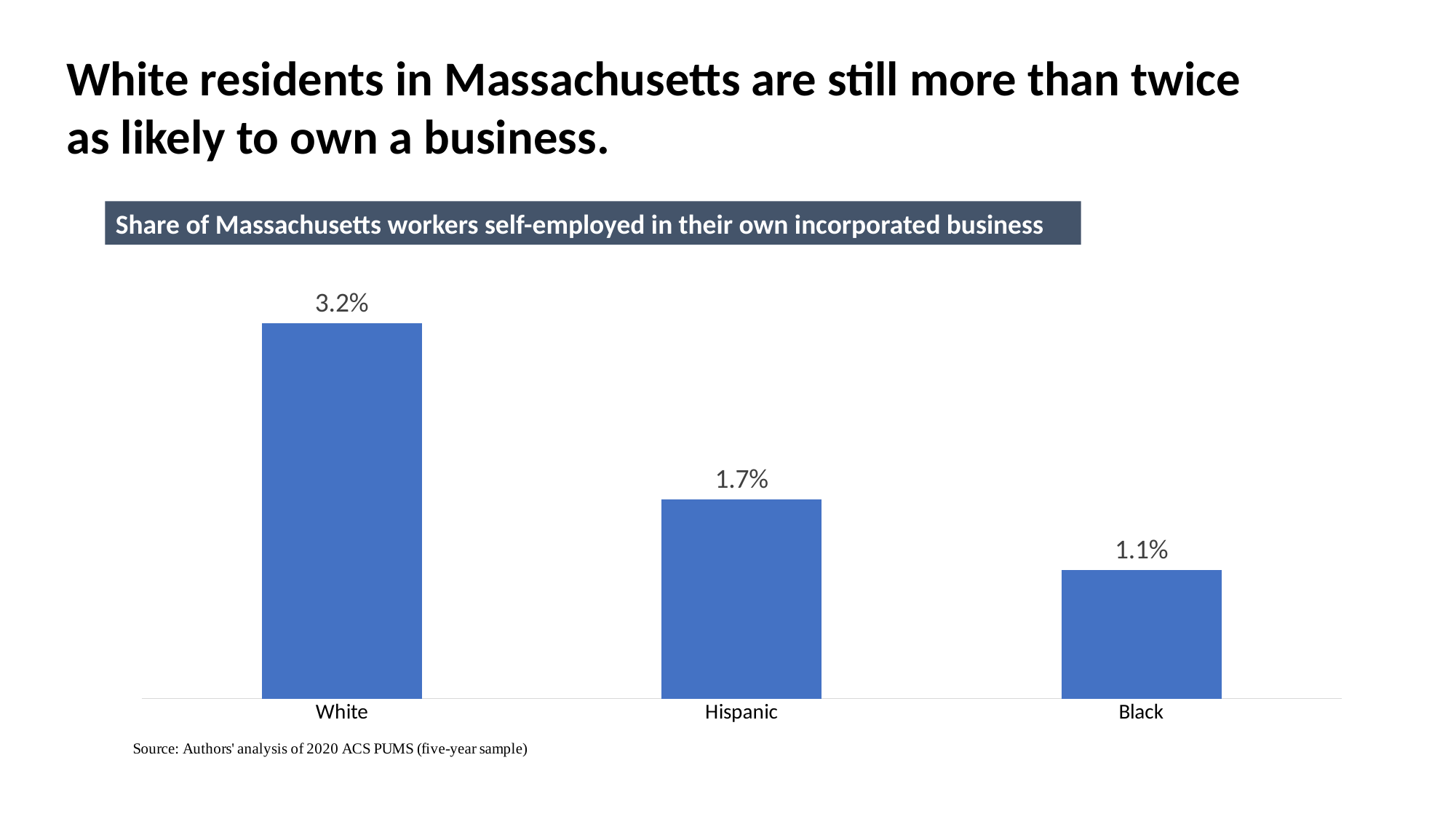
What is the title of the chart? Share of Massachusetts workers self-employed in their own incorporated business Which group has the lowest share of workers self-employed in their own incorporated business? Black What kind of chart is shown on the slide? Bar chart What is the difference in percentage points between the White and Black shares? 2.1 percentage points Which is larger, the share for Hispanic workers or the share for Black workers? Hispanic How many groups are shown in the chart? 3 What is the share of Black Massachusetts workers self-employed in their own incorporated business? 1.1% Which group has the highest share of workers self-employed in their own incorporated business? White What is the share of Hispanic Massachusetts workers self-employed in their own incorporated business? 1.7% What is the difference in percentage points between the Hispanic and Black shares? 0.6 percentage points Do the values rise or fall moving from left to right across the chart? Fall What is the share of White Massachusetts workers self-employed in their own incorporated business? 3.2%